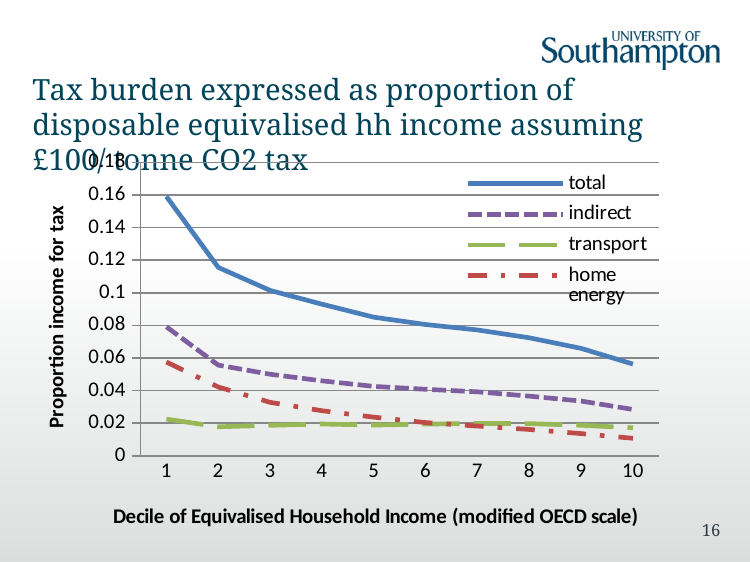
Is the value of the 'indirect' series at decile 1 greater or less than 0.06? greater Does the 'total' series rise or fall from decile 1 to decile 10? fall At which decile is the 'total' series lowest? 10 What is the title of the x axis? Decile of Equivalised Household Income (modified OECD scale) What kind of chart is shown on the slide? line chart How many series does the legend list? 4 At which decile is the 'total' series highest? 1 At decile 1, which is larger: the 'indirect' value or the 'home energy' value? indirect How many deciles are plotted along the x axis? 10 Is the value of the 'transport' series at decile 1 greater or less than 0.04? less Is the value of the 'total' series at decile 10 greater or less than 0.08? less